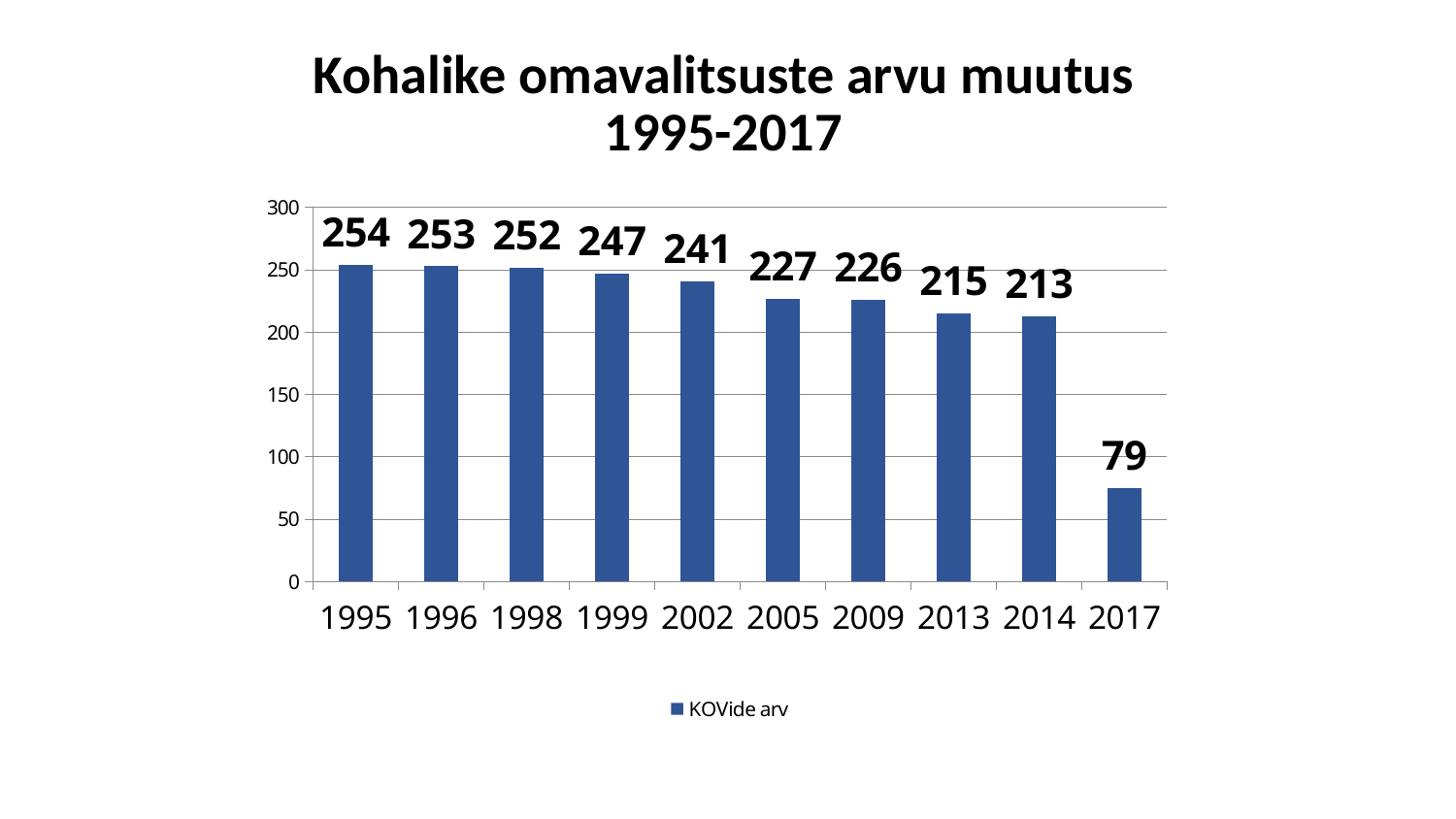
What is the value for 2005? 227 What is the difference between the values for 2014 and 2017? 134 Do the values rise or fall from 1995 to 2017? fall What kind of chart is shown? bar chart What is the value for 1995? 254 Which year has the lowest value? 2017 How many series does the legend list? 1 What is the value for 2017? 79 Which is larger, the value for 1999 or the value for 2013? 1999 What is the difference between the values for 1995 and 2002? 13 Which year has the highest value? 1995 How many years are shown on the x axis? 10